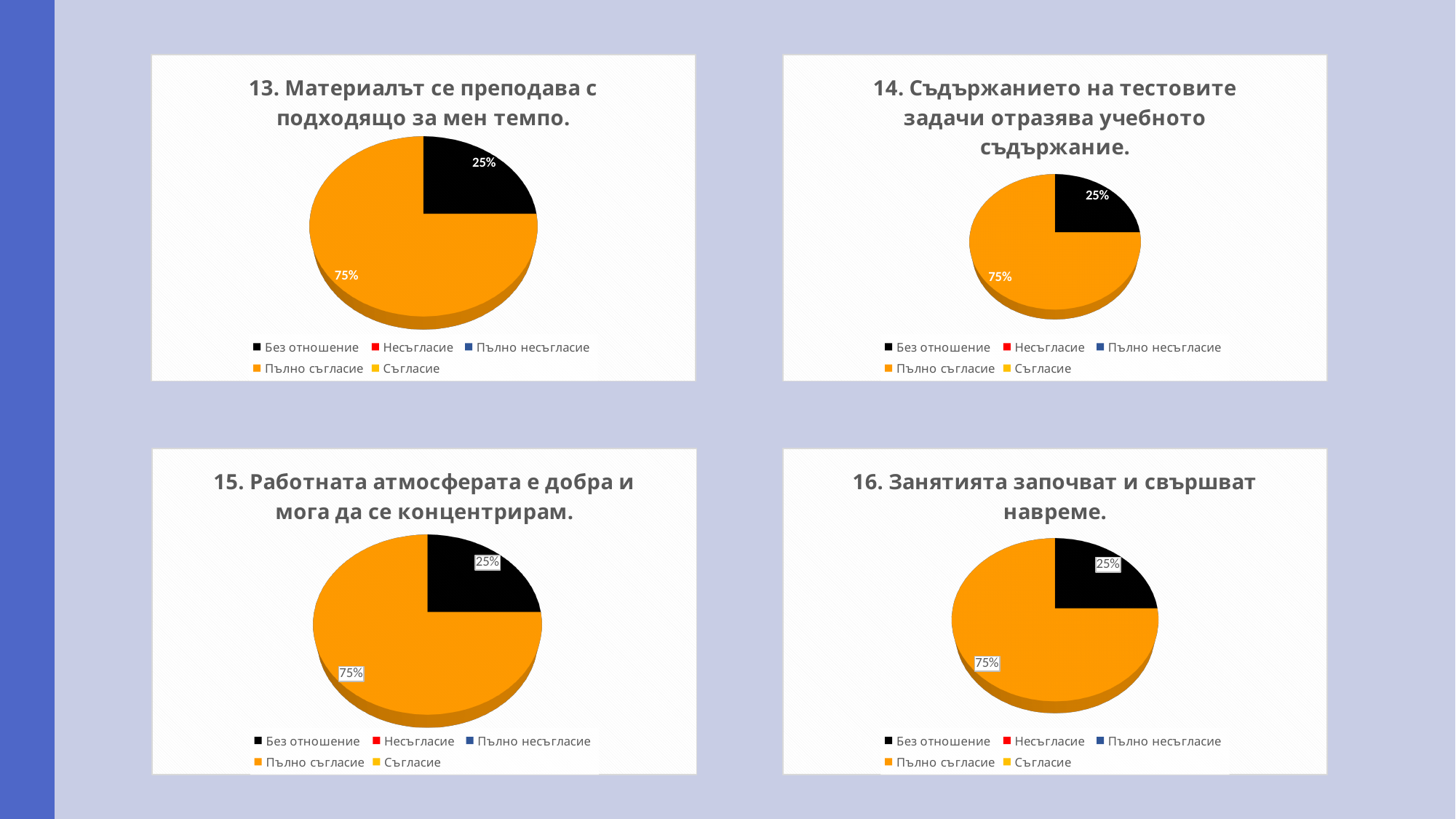
In the chart titled "13. Материалът се преподава с подходящо за мен темпо.", what share of the pie is "Пълно съгласие"? 75% In the chart titled "16. Занятията започват и свършват навреме.", how many categories does the legend list? 5 In the chart titled "15. Работната атмосферата е добра и мога да се концентрирам.", what share of the pie is "Без отношение"? 25% In the chart titled "14. Съдържанието на тестовите задачи отразява учебното съдържание.", what is the difference between the "Пълно съгласие" and "Без отношение" slices? 50% In the chart titled "16. Занятията започват и свършват навреме.", how many slices are visible in the pie? 2 In the chart titled "14. Съдържанието на тестовите задачи отразява учебното съдържание.", what colour is the "Без отношение" slice? Black In the chart titled "13. Материалът се преподава с подходящо за мен темпо.", what share of the pie is "Без отношение"? 25% In the chart titled "14. Съдържанието на тестовите задачи отразява учебното съдържание.", which category has the largest slice? Пълно съгласие What type of chart is the chart titled "13. Материалът се преподава с подходящо за мен тempo."? Pie chart In the chart titled "15. Работната атмосферата е добра и мога да се концентрирам.", which is larger, "Пълно съгласие" or "Без отношение"? Пълно съгласие How many pie charts are shown on the slide? 4